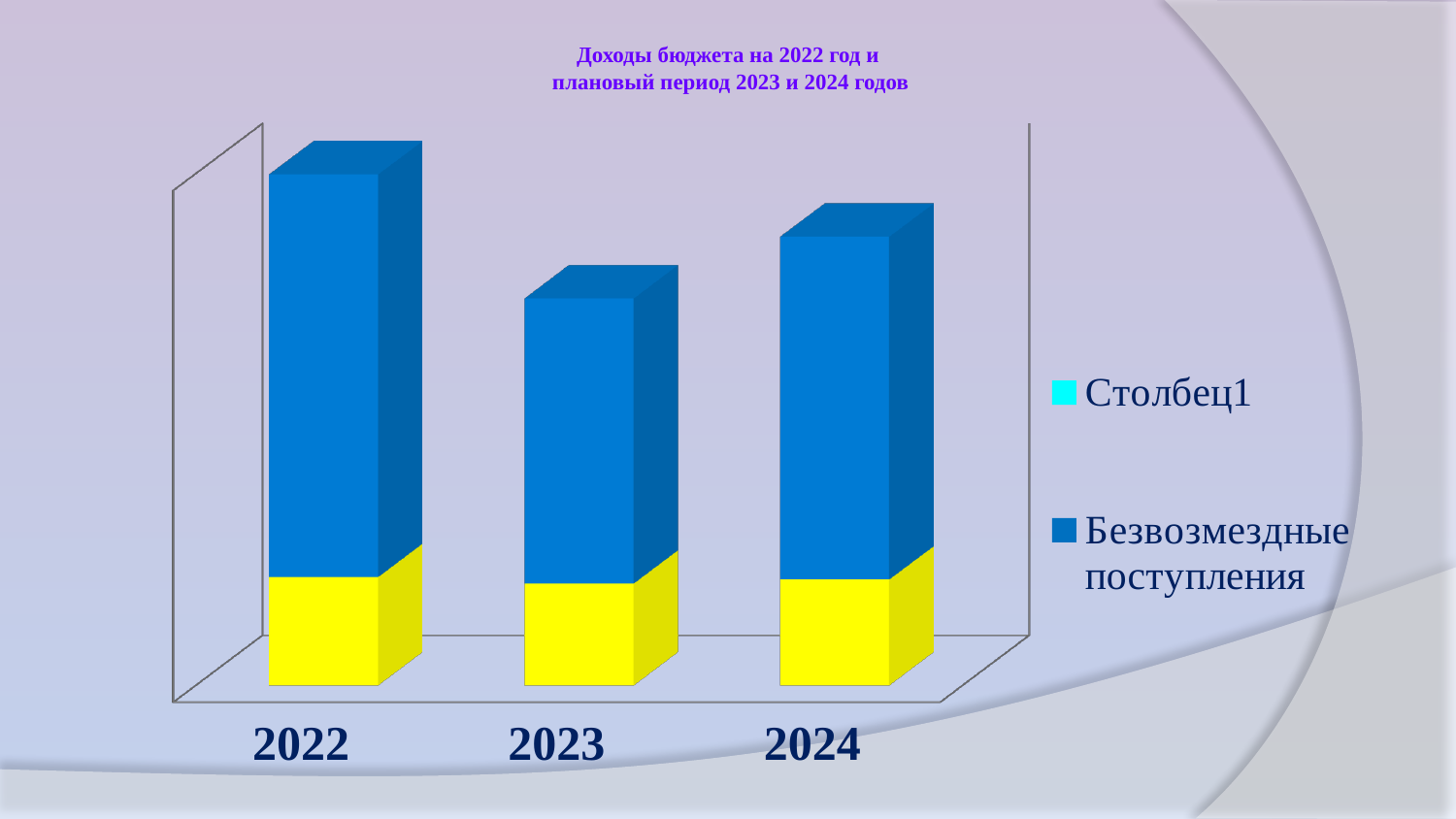
Which year has the smallest 'Безвозмездные поступления' segment? 2023 Which year has the tallest stacked bar in the chart? 2022 How many series does the chart's legend list? 2 Which year has the larger total bar, 2022 or 2023? 2022 Which year has the largest 'Безвозмездные поступления' segment? 2022 What kind of chart is shown on the slide? bar chart Which series in the legend is shown in blue? Безвозмездные поступления How many categories (years) are shown on the x axis of the chart? 3 Which year has the larger total bar, 2024 or 2023? 2024 What is the title of the chart? Доходы бюджета на 2022 год и плановый период 2023 и 2024 годов Does the total bar height rise or fall from 2022 to 2023? fall Which year has the shortest stacked bar in the chart? 2023